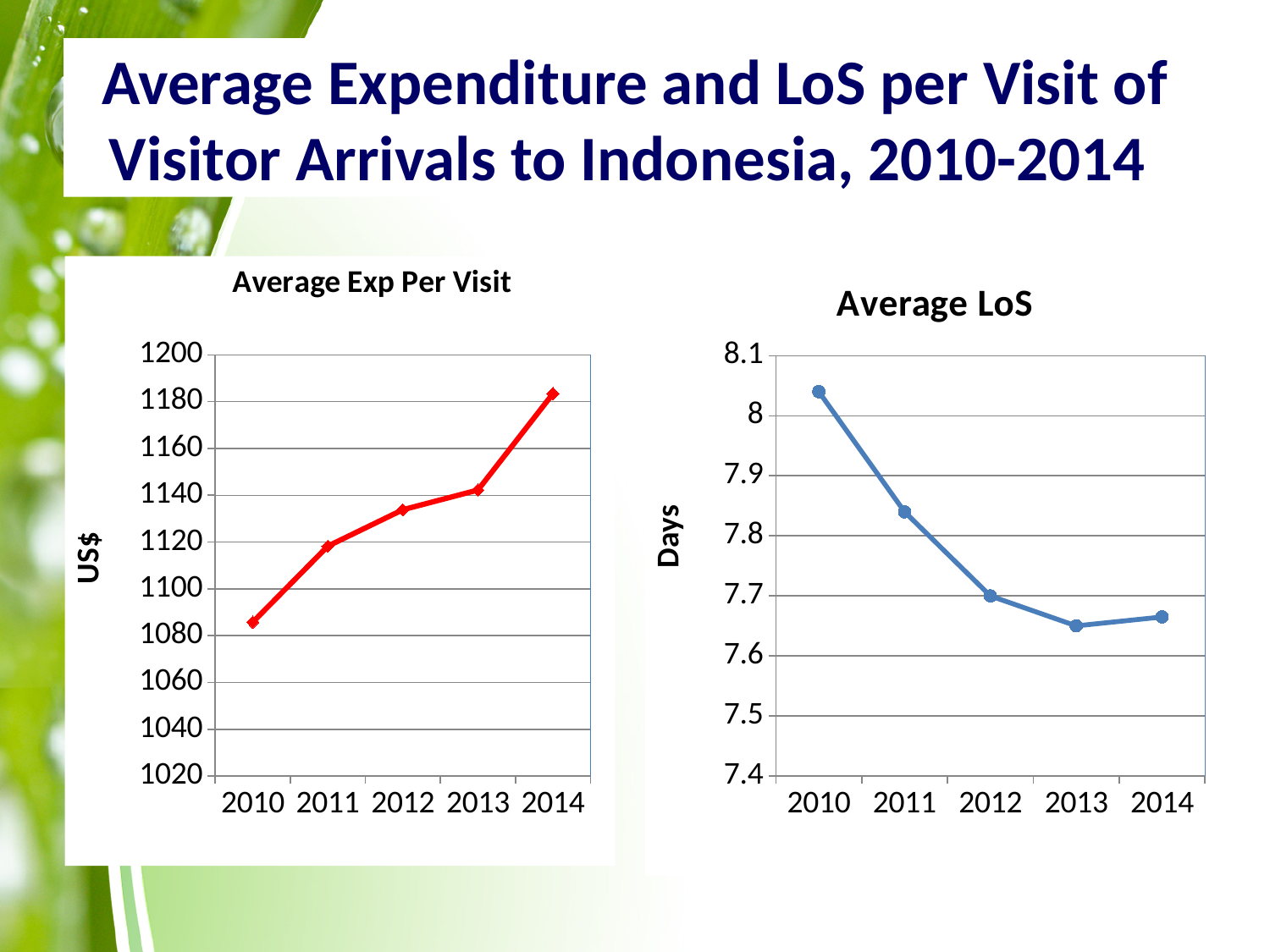
In the "Average Exp Per Visit" chart, is the value for 2014 greater or less than 1160? greater Do the values in the "Average Exp Per Visit" chart rise or fall from 2010 to 2014? rise In the "Average Exp Per Visit" chart, which year has the highest value? 2014 In the "Average Exp Per Visit" chart, which year has the lowest value? 2010 In the "Average LoS" chart, which year has the highest value? 2010 What kind of chart is the "Average Exp Per Visit" chart? line chart How many years are plotted on the "Average LoS" chart? 5 In the "Average Exp Per Visit" chart, is the value for 2010 greater or less than 1100? less In the "Average LoS" chart, is the value for 2010 greater or less than 8? greater In the "Average LoS" chart, which is larger, the value for 2010 or the value for 2014? 2010 What is the y-axis label of the "Average LoS" chart? Days